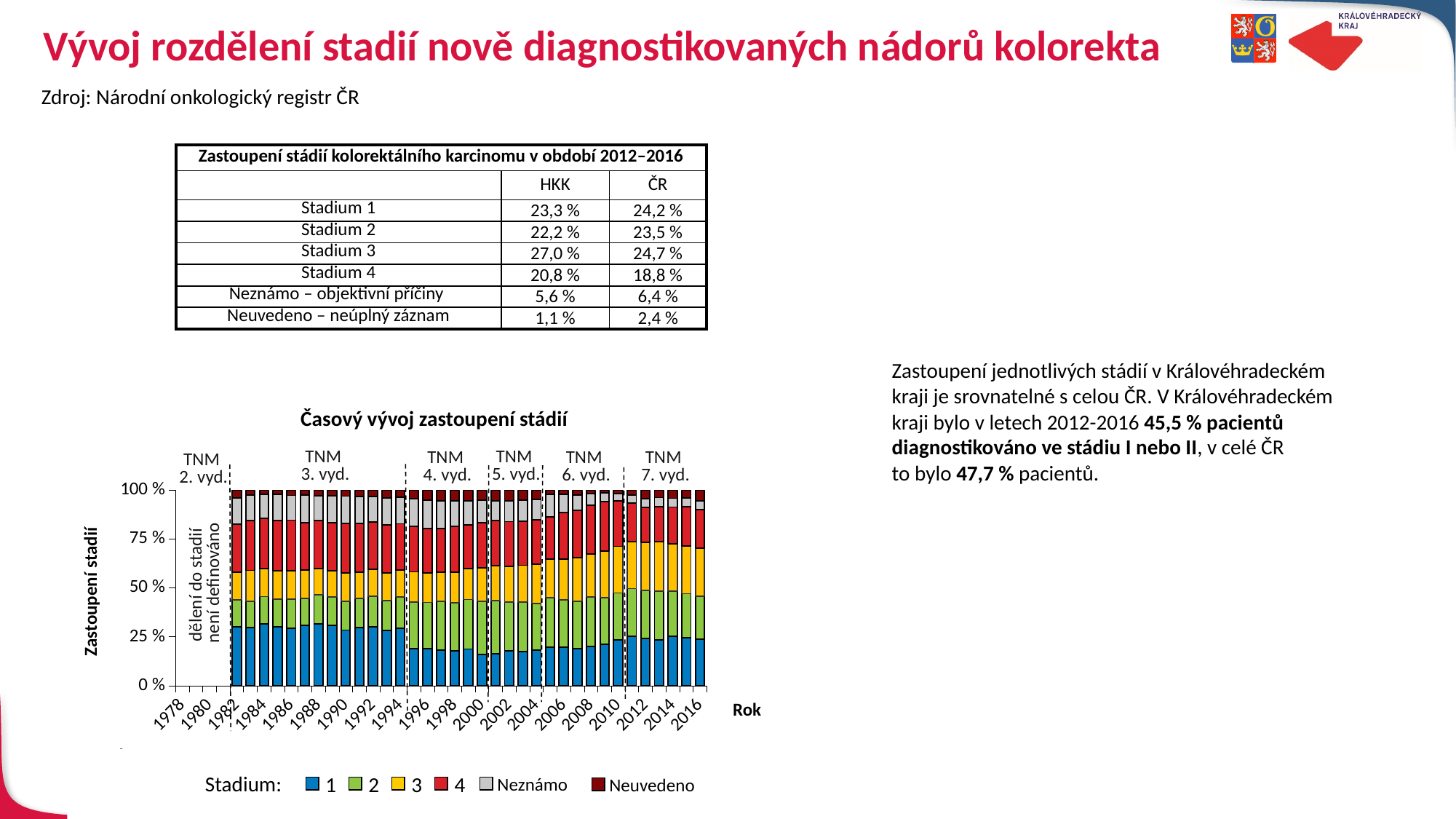
In the chart 'Časový vývoj zastoupení stádií', what is the total of the stacked bar for 2016? 100 % How many series does the legend of the chart 'Časový vývoj zastoupení stádií' list? 6 In the chart 'Časový vývoj zastoupení stádií', which is larger in 1982: the share of Stadium 1 or the share of Stadium 2? Stadium 1 What is the title of the chart on the slide? Časový vývoj zastoupení stádií In the chart 'Časový vývoj zastoupení stádií', what colour represents Stadium 1? blue In the chart 'Časový vývoj zastoupení stádií', is the share of Stadium 1 in 2000 greater or less than 25 %? less How many year labels are shown on the x axis of the chart 'Časový vývoj zastoupení stádií'? 20 What kind of chart is 'Časový vývoj zastoupení stádií'? stacked bar chart In the chart 'Časový vývoj zastoupení stádií', is the share of Stadium 1 in 1982 greater or less than 25 %? greater In the chart 'Časový vývoj zastoupení stádií', is the share of Stadium 1 in 1996 greater or less than 25 %? less